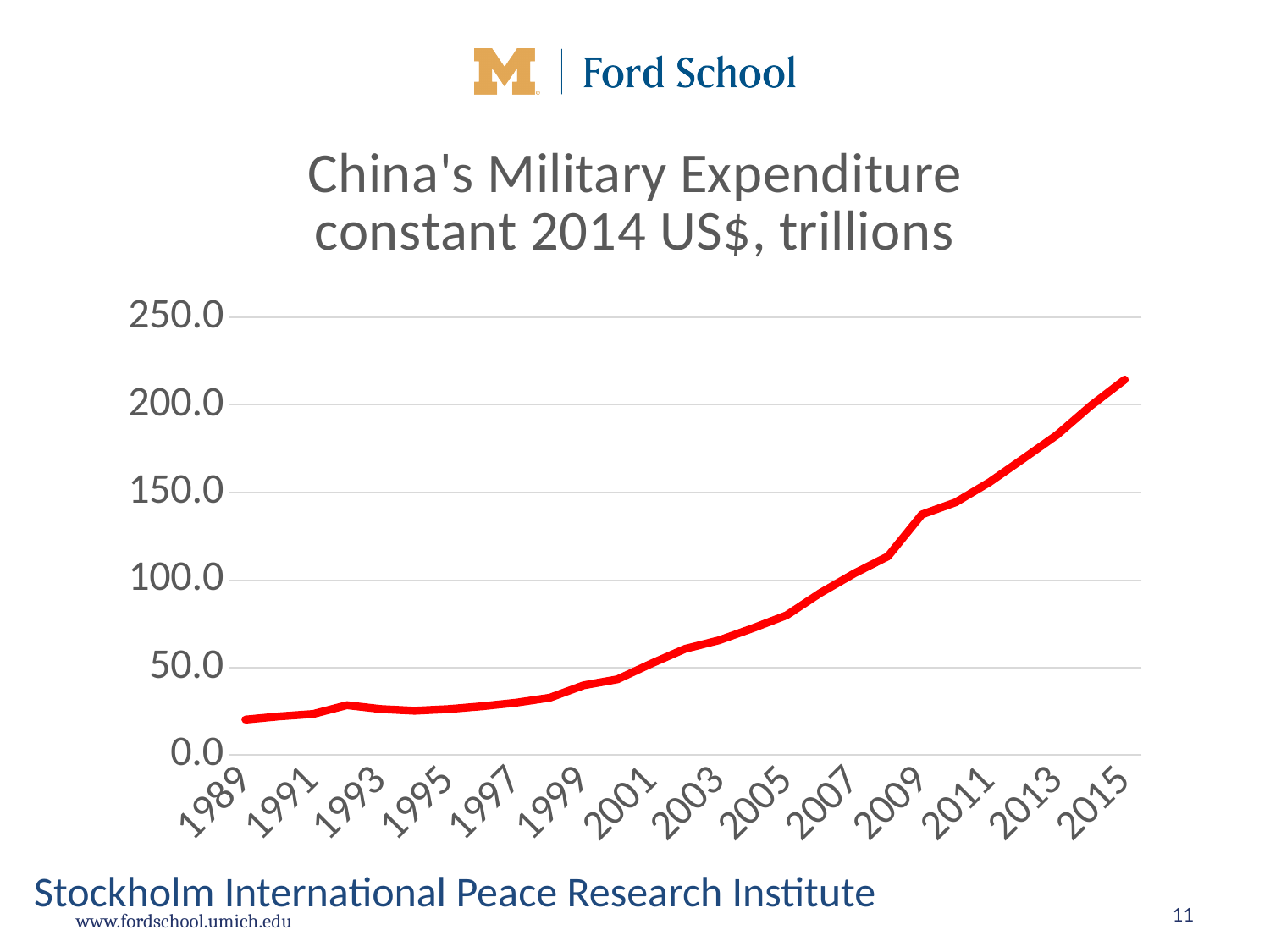
What kind of chart is shown on the slide? line chart What is the first year shown on the x axis? 1989 What is the highest value shown on the y axis? 250.0 Is the value for 2015 greater or less than 200.0? greater Is the value for 2005 greater or less than 50.0? greater Which is larger, the value for 2009 or the value for 2003? 2009 What is the title of the chart? China's Military Expenditure constant 2014 US$, trillions Is the value for 2009 greater or less than 150.0? less Which year has the highest value on the chart? 2015 Do the values rise or fall from 1989 to 2015? rise